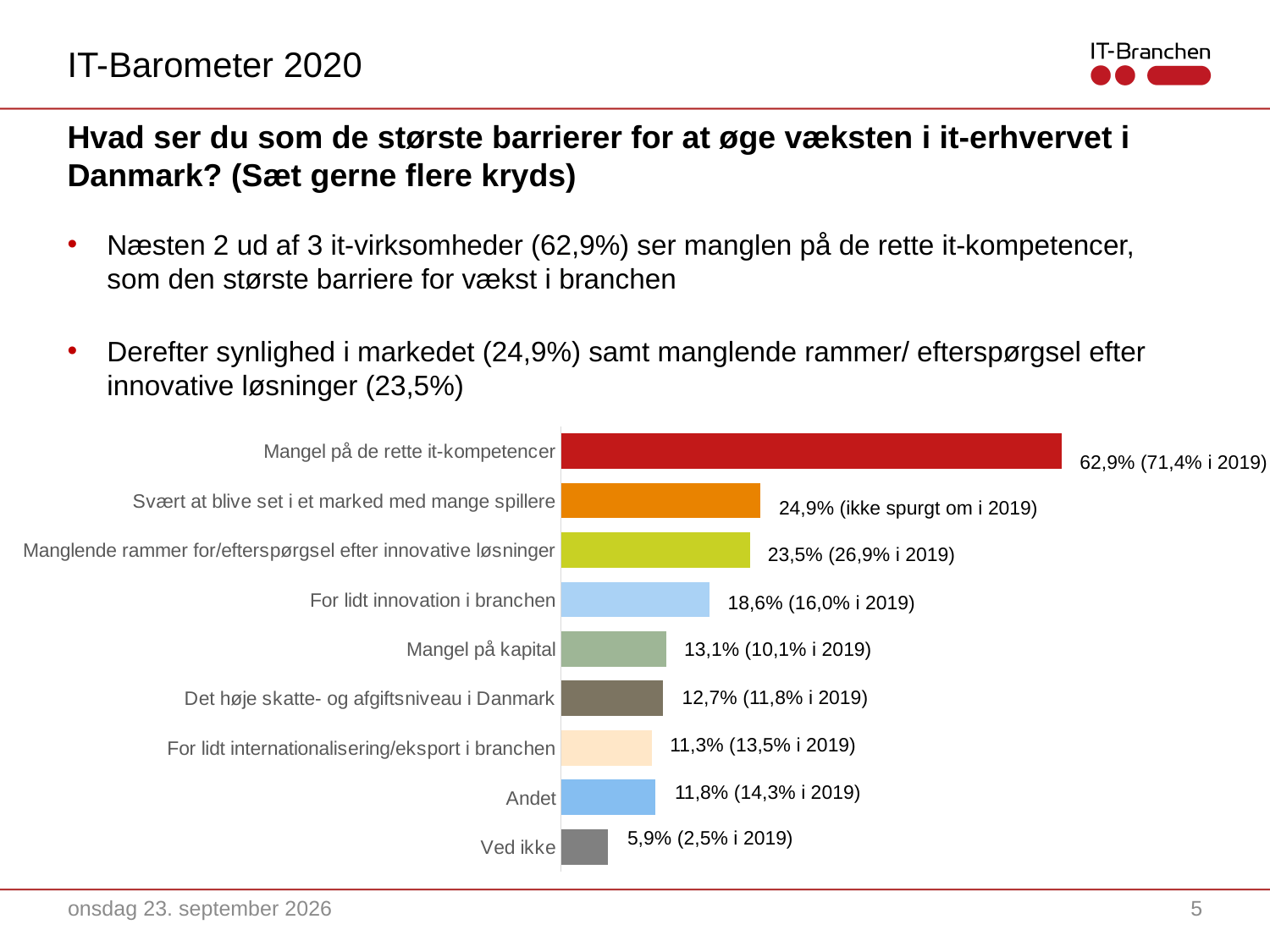
Which category has the lowest value in the chart? Ved ikke Which is larger: the value for 'Andet' or the value for 'For lidt internationalisering/eksport i branchen'? Andet Which category has the highest value in the chart? Mangel på de rette it-kompetencer What is the value for 'For lidt innovation i branchen'? 18,6% What was the 2019 value for 'Mangel på de rette it-kompetencer' according to the data label? 71,4% What is the difference between the values for 'Mangel på de rette it-kompetencer' (62,9%) and 'Svært at blive set i et marked med mange spillere' (24,9%)? 38,0 percentage points What is the 2019 value shown in the label for 'Mangel på kapital'? 10,1% What is the 2020 value for 'Mangel på de rette it-kompetencer'? 62,9% What does the data label say about the 2019 value for 'Svært at blive set i et marked med mange spillere'? ikke spurgt om i 2019 How many categories (bars) does the chart show? 9 What is the value for 'Ved ikke'? 5,9% What kind of chart is shown on the slide? bar chart